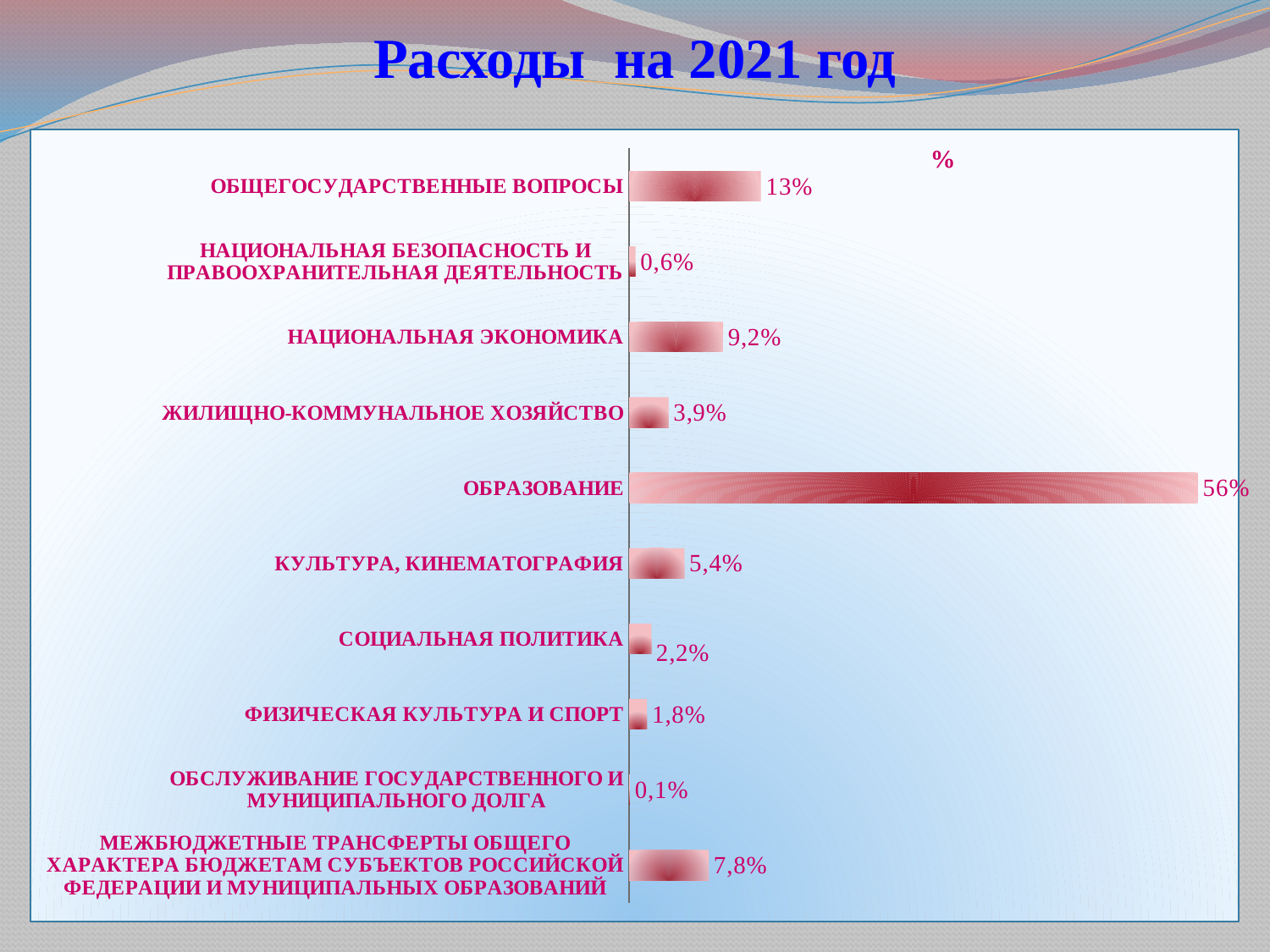
What is the difference between the values for ОБЩЕГОСУДАРСТВЕННЫЕ ВОПРОСЫ and НАЦИОНАЛЬНАЯ ЭКОНОМИКА? 3,8% What is the value for НАЦИОНАЛЬНАЯ ЭКОНОМИКА? 9,2% What is the value for ЖИЛИЩНО-КОММУНАЛЬНОЕ ХОЗЯЙСТВО? 3,9% How many categories are shown in the chart? 10 Which category has the lowest value? ОБСЛУЖИВАНИЕ ГОСУДАРСТВЕННОГО И МУНИЦИПАЛЬНОГО ДОЛГА What is the difference between the values for ФИЗИЧЕСКАЯ КУЛЬТУРА И СПОРТ and НАЦИОНАЛЬНАЯ БЕЗОПАСНОСТЬ И ПРАВООХРАНИТЕЛЬНАЯ ДЕЯТЕЛЬНОСТЬ? 1,2% What is the value for ОБРАЗОВАНИЕ? 56% What is the value for ОБСЛУЖИВАНИЕ ГОСУДАРСТВЕННОГО И МУНИЦИПАЛЬНОГО ДОЛГА? 0,1% What kind of chart is shown on the slide? Bar chart What is the title of the slide? Расходы на 2021 год Which category has the highest value? ОБРАЗОВАНИЕ Which is larger: the value for КУЛЬТУРА, КИНЕМАТОГРАФИЯ or the value for СОЦИАЛЬНАЯ ПОЛИТИКА? КУЛЬТУРА, КИНЕМАТОГРАФИЯ